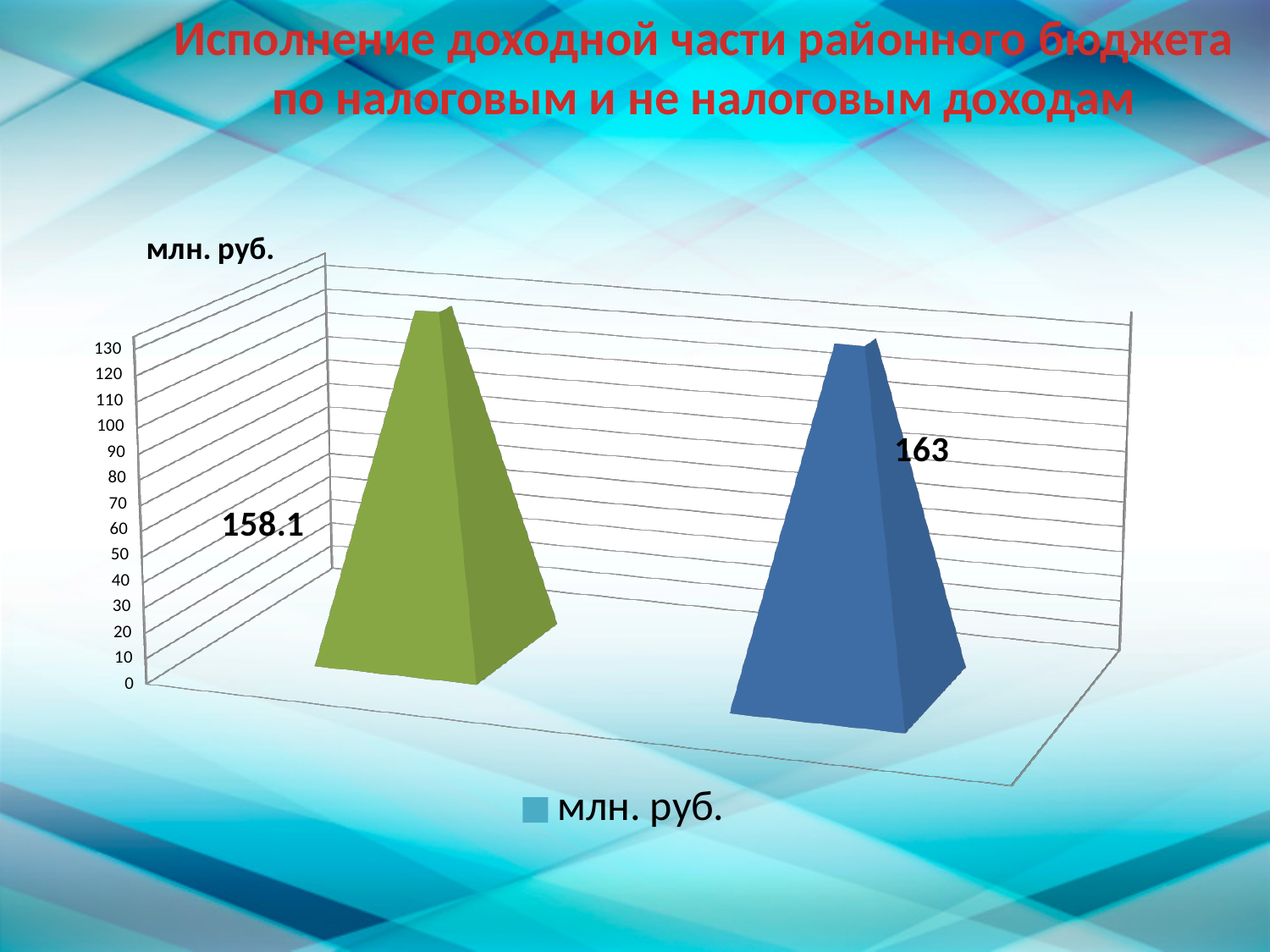
Is the value of the blue bar larger or smaller than the value of the green bar? larger Which bar has the higher value, the green one or the blue one? the blue bar What value is printed on the green bar? 158.1 How many bars are plotted on the chart? 2 What unit is shown in the legend of the chart? млн. руб. What is the difference between the blue bar's value (163) and the green bar's value (158.1)? 4.9 What kind of chart is shown on the slide? bar chart What is the title of the slide? Исполнение доходной части районного бюджета по налоговым и не налоговым доходам What value is printed on the blue bar? 163 How many entries does the legend list? 1 Which bar has the lower value, the green one or the blue one? the green bar